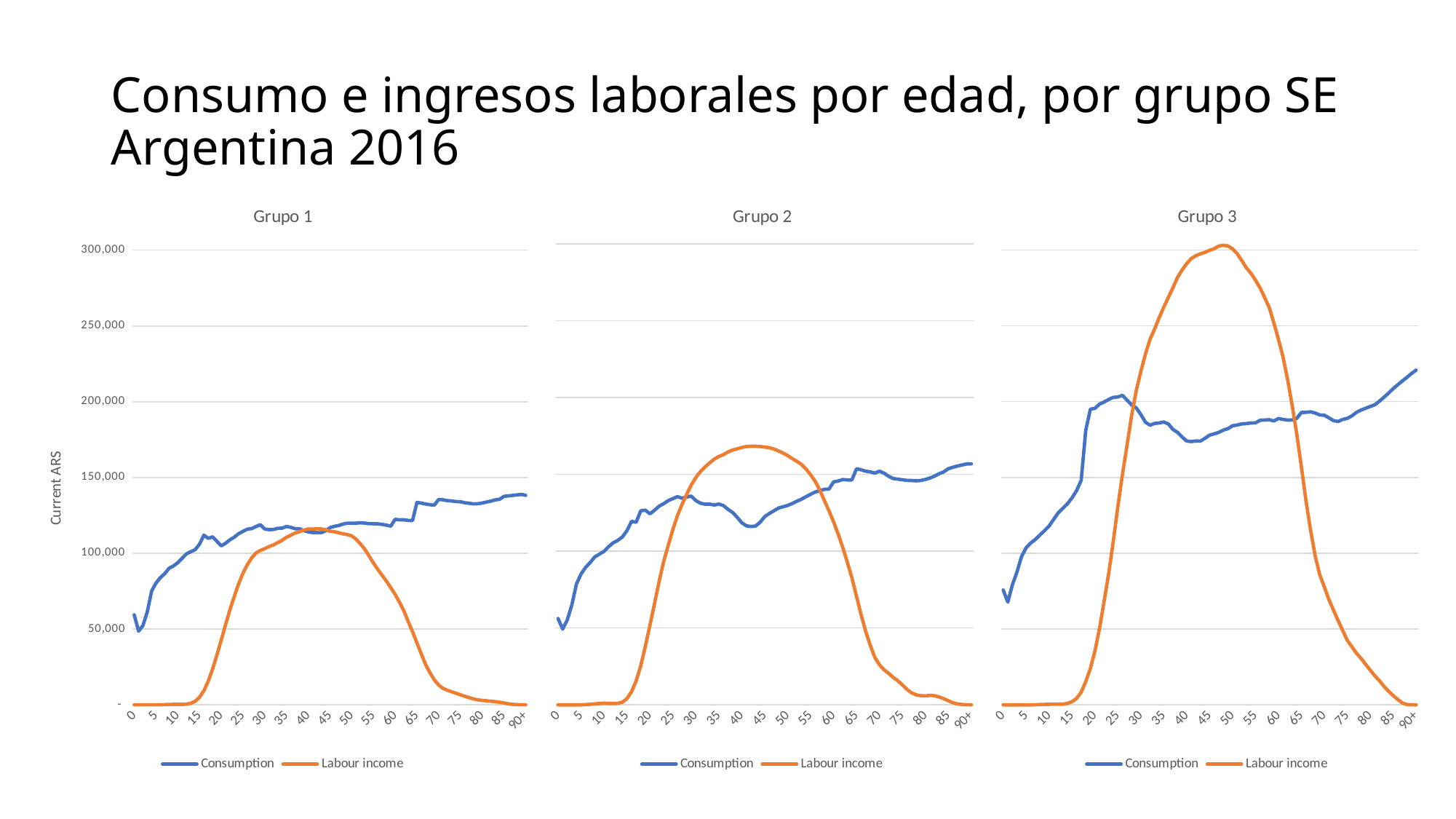
In the Grupo 2 chart, is the Labour income value at age 80 greater or less than 50,000? less In the Grupo 1 chart, is the Labour income value at age 40 greater or less than 150,000? less How many charts are shown on the slide? 3 In the Grupo 2 chart, is the Labour income value at age 45 greater or less than 150,000? greater In the Grupo 1 chart, at age 20, which is larger: Consumption or Labour income? Consumption How many series does the legend of the Grupo 2 chart list? 2 In the Grupo 3 chart, does Labour income rise or fall from age 50 to age 90+? fall What kind of chart is used for Grupo 1? Line chart In the Grupo 3 chart, at age 50, which is larger: Consumption or Labour income? Labour income What is the label on the vertical axis of the Grupo 1 chart? Current ARS